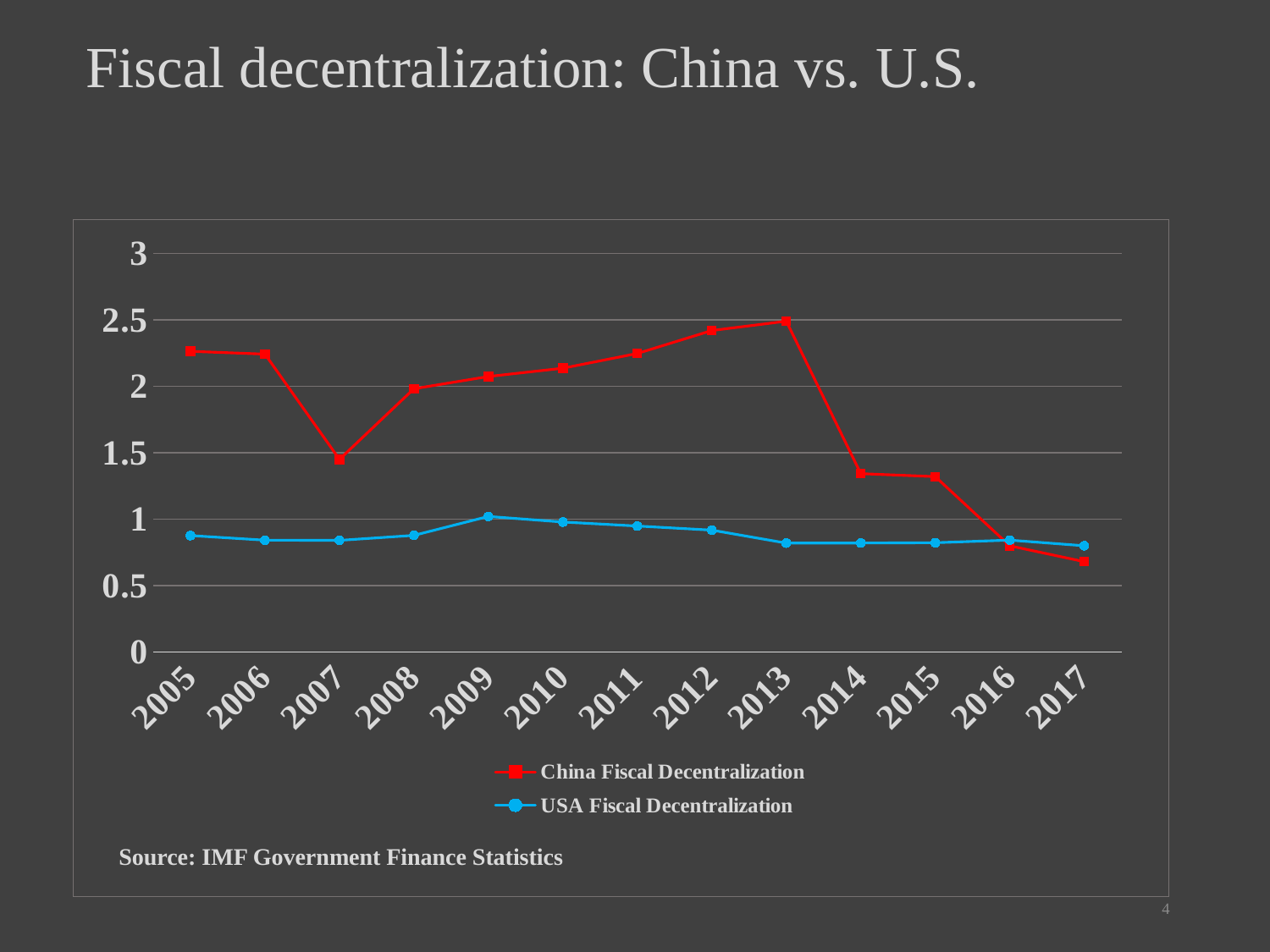
How many years are plotted along the x axis? 13 Is the value for China Fiscal Decentralization in 2013 greater or less than 2? greater How many series does the legend list? 2 What source is cited for the chart data? IMF Government Finance Statistics Does China Fiscal Decentralization rise or fall from 2008 to 2013? rise In which year does China Fiscal Decentralization reach its highest value? 2013 In which year does USA Fiscal Decentralization reach its highest value? 2009 What kind of chart is shown on the slide? line chart Is the value for China Fiscal Decentralization in 2007 greater or less than 2? less Which series has the larger value in 2010, China Fiscal Decentralization or USA Fiscal Decentralization? China Fiscal Decentralization Is the value for USA Fiscal Decentralization in 2005 greater or less than 1? less In which year does China Fiscal Decentralization reach its lowest value? 2017